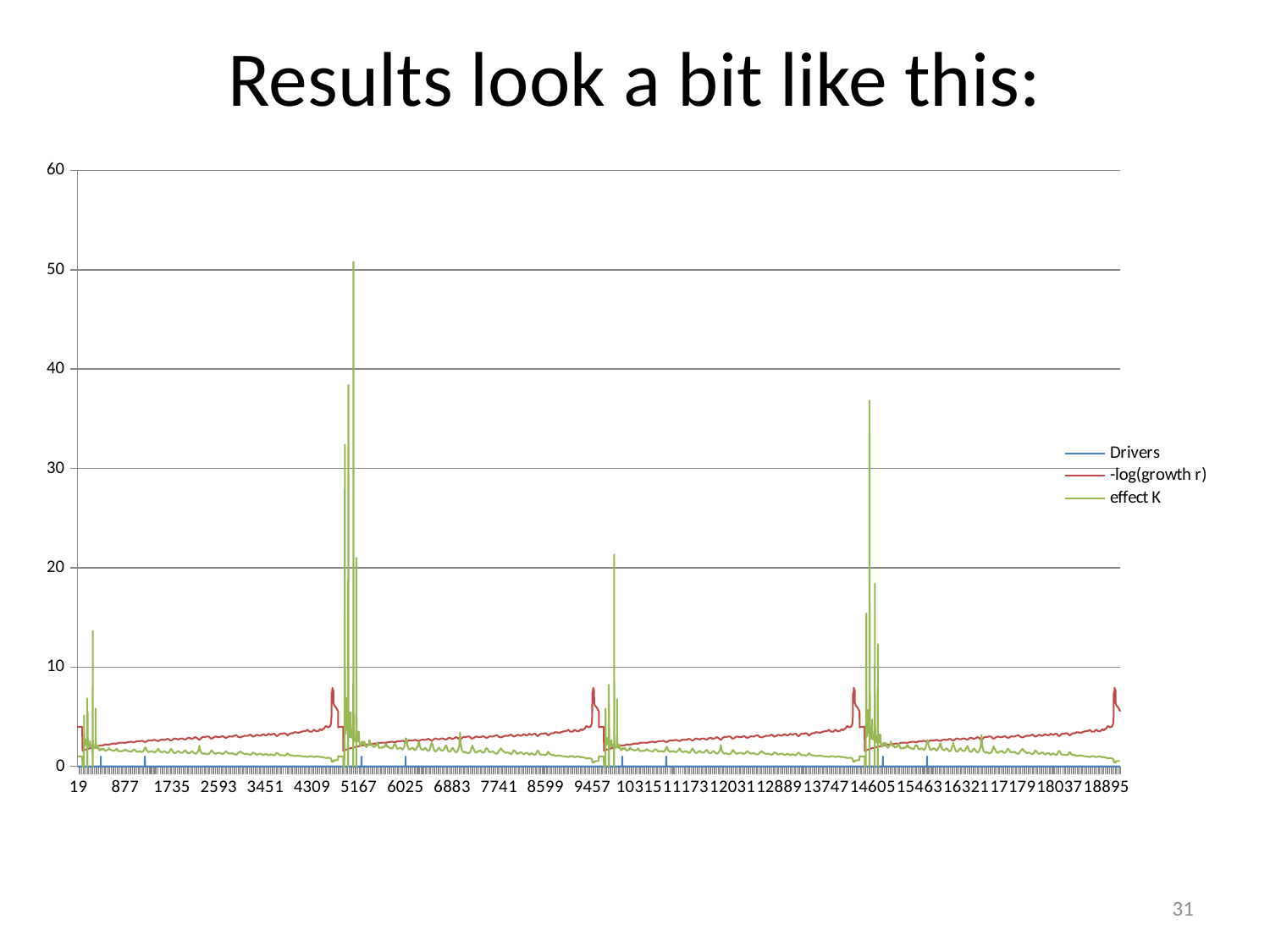
What kind of chart is shown on the slide? line chart What is the last label shown on the x axis? 18895 How many labelled tick marks are there on the x axis? 23 What is the maximum value shown on the y axis? 60 How many series does the legend list? 3 Is the highest peak of the effect K series greater or less than 40? greater Which series reaches the highest value on the chart? effect K Is the Drivers series greater or less than 10 across the whole chart? less Which series stays lowest across the chart, Drivers or -log(growth r)? Drivers Is the highest value of the -log(growth r) series greater or less than 10? less